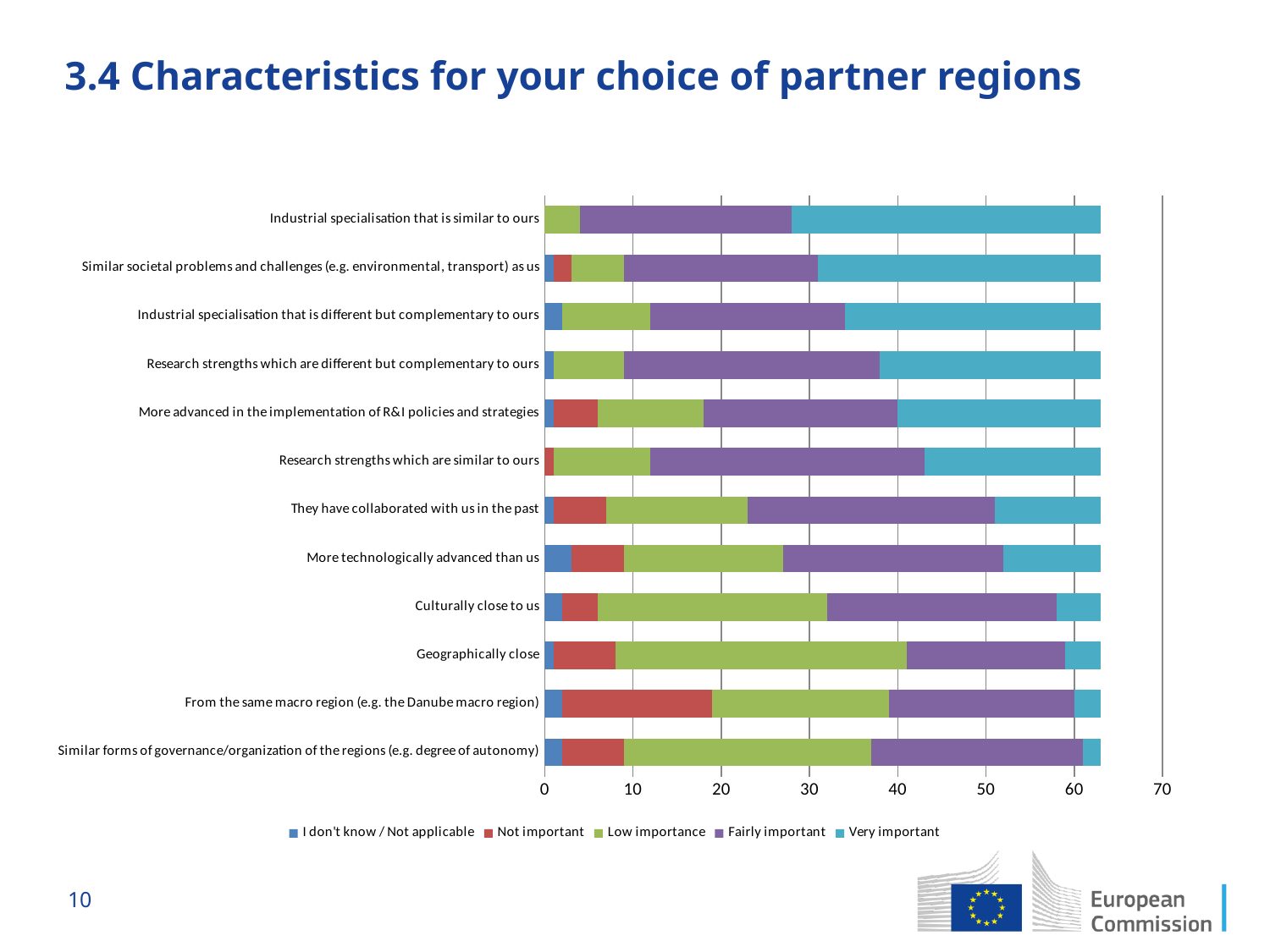
Which category has the largest 'Low importance' segment? Geographically close What is the title of the slide containing the chart? 3.4 Characteristics for your choice of partner regions Which legend entry is shown in purple? Fairly important Is the 'Low importance' segment larger for 'Culturally close to us' or for 'Industrial specialisation that is similar to ours'? Culturally close to us How many series does the legend list? 5 Is the 'Not important' segment for 'From the same macro region (e.g. the Danube macro region)' greater or less than 10? greater Is the total length of the bar for 'They have collaborated with us in the past' greater or less than 60? greater What kind of chart is shown on the slide? Stacked bar chart How many categories (partner region characteristics) are plotted on the chart? 12 Which category has the largest 'Very important' segment? Industrial specialisation that is similar to ours Is the 'Very important' segment larger for 'Industrial specialisation that is similar to ours' or for 'Geographically close'? Industrial specialisation that is similar to ours Which category has the largest 'Not important' segment? From the same macro region (e.g. the Danube macro region)